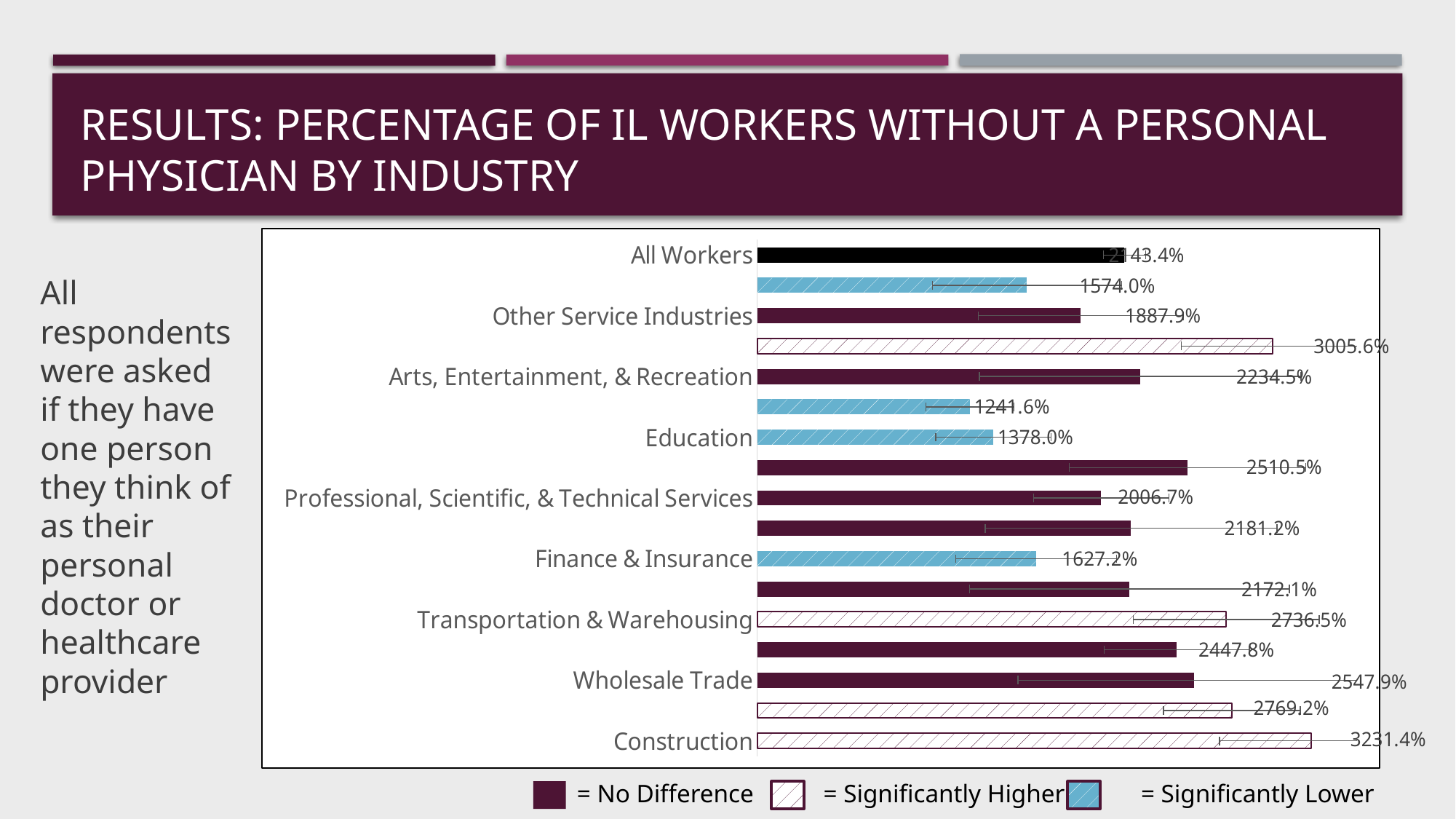
According to the legend, what does the blue hatched bar fill indicate? Significantly Lower How many industry categories are labelled on the vertical axis, including All Workers? 9 According to the legend, what does the white hatched bar fill for Construction indicate? Significantly Higher Which bar is longer, Construction or All Workers? Construction Which bar is longer, Transportation & Warehousing or Professional, Scientific, & Technical Services? Transportation & Warehousing How many bars are plotted in the chart? 17 Which bar is longer, Other Service Industries or Education? Other Service Industries How many entries does the legend list? 3 Which labelled category has the longest bar? Construction What kind of chart is shown on the slide? bar chart